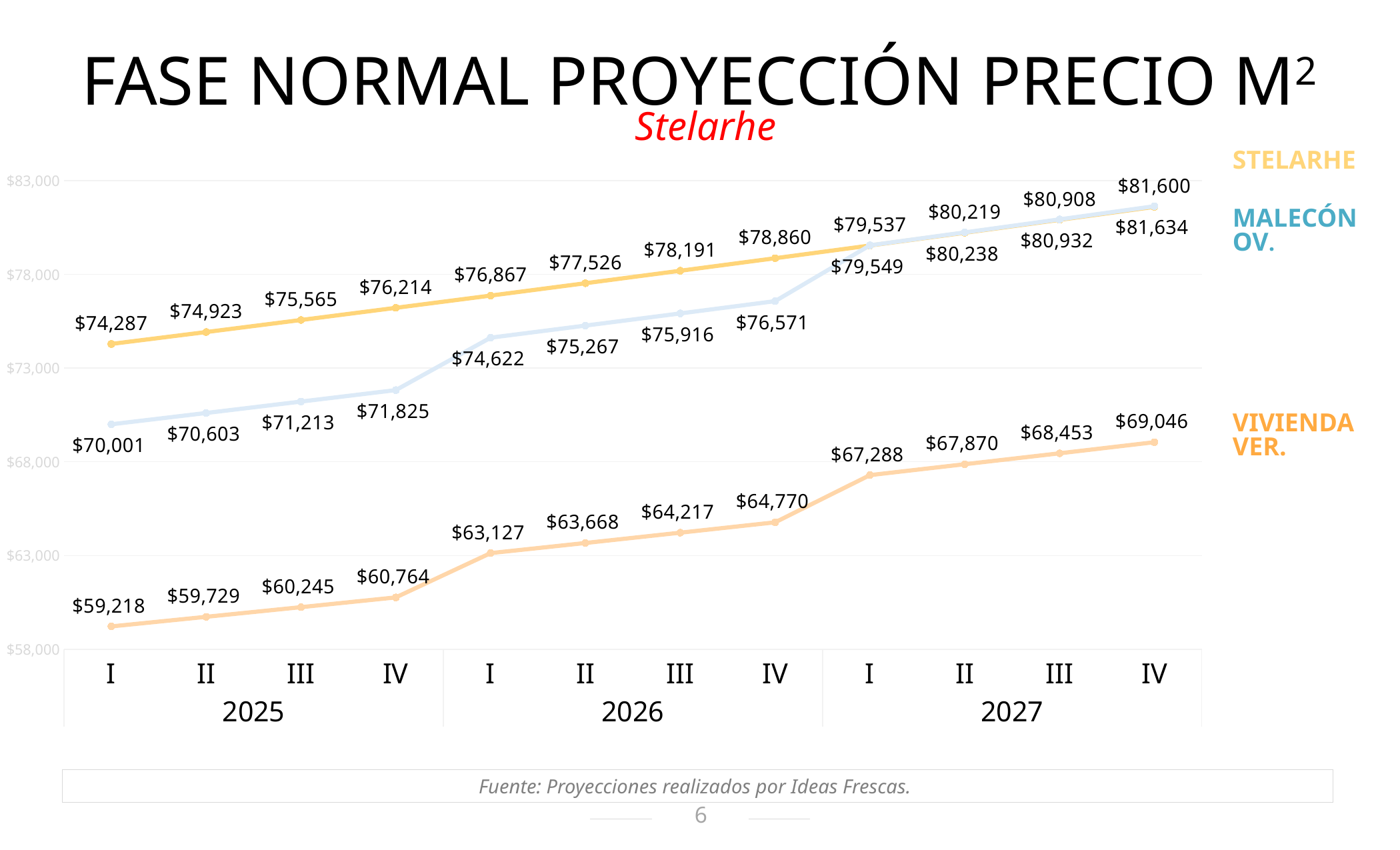
What is the source cited below the chart? Proyecciones realizados por Ideas Frescas. Which series has the lowest value in quarter I of 2025? VIVIENDA VER. How many series does the chart show? 3 What is the MALECÓN OV. value in quarter IV of 2027? $81,634 Which is larger in quarter I of 2027: the STELARHE value or the MALECÓN OV. value? MALECÓN OV. What is the STELARHE value in quarter I of 2025? $74,287 Which series has the highest value in quarter IV of 2026? STELARHE What kind of chart is shown on the slide? line chart What is the difference between the STELARHE and VIVIENDA VER. values in quarter IV of 2027? $12,554 Do the VIVIENDA VER. values rise or fall from 2025 to 2027? rise How many quarterly points are plotted for each series? 12 What is the VIVIENDA VER. value in quarter I of 2026? $63,127